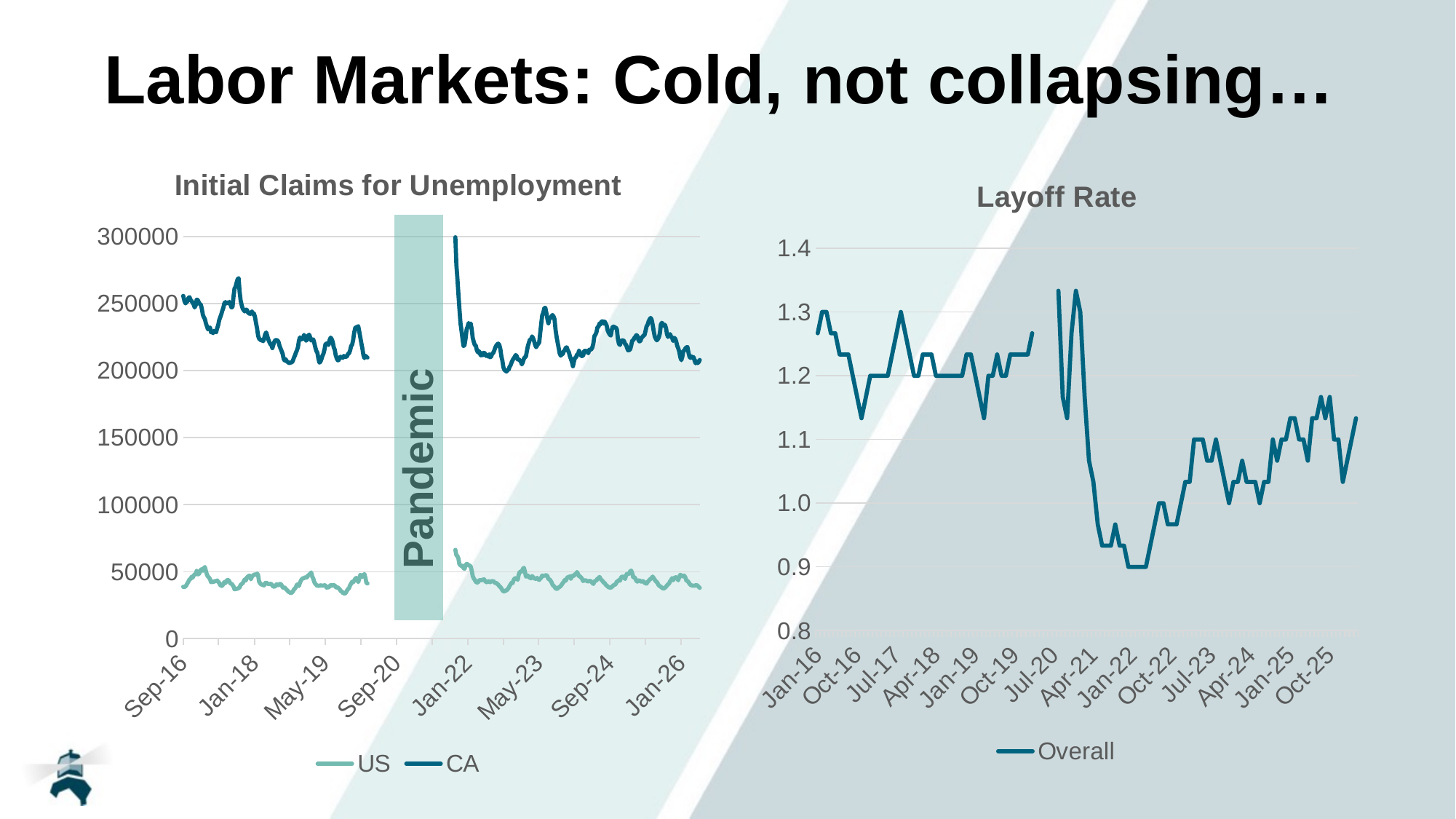
What kind of chart is the Layoff Rate chart? line chart In the Initial Claims for Unemployment chart, is the US value at Jan-26 greater or less than 100000? less What are the legend entries of the Initial Claims for Unemployment chart? US and CA In the Layoff Rate chart, does the Overall series generally rise or fall from Jan-22 to Oct-25? rise In the Layoff Rate chart, is the value at Jan-16 greater or less than 1.2? greater What kind of chart is the Initial Claims for Unemployment chart? line chart How many series does the legend of the Initial Claims for Unemployment chart list? 2 In the Initial Claims for Unemployment chart, which series has the higher values throughout, US or CA? CA In the Initial Claims for Unemployment chart, what label is written on the shaded vertical band between the two segments of the lines? Pandemic In the Layoff Rate chart, is the value at Jan-22 greater or less than 1.0? less How many series does the legend of the Layoff Rate chart list? 1